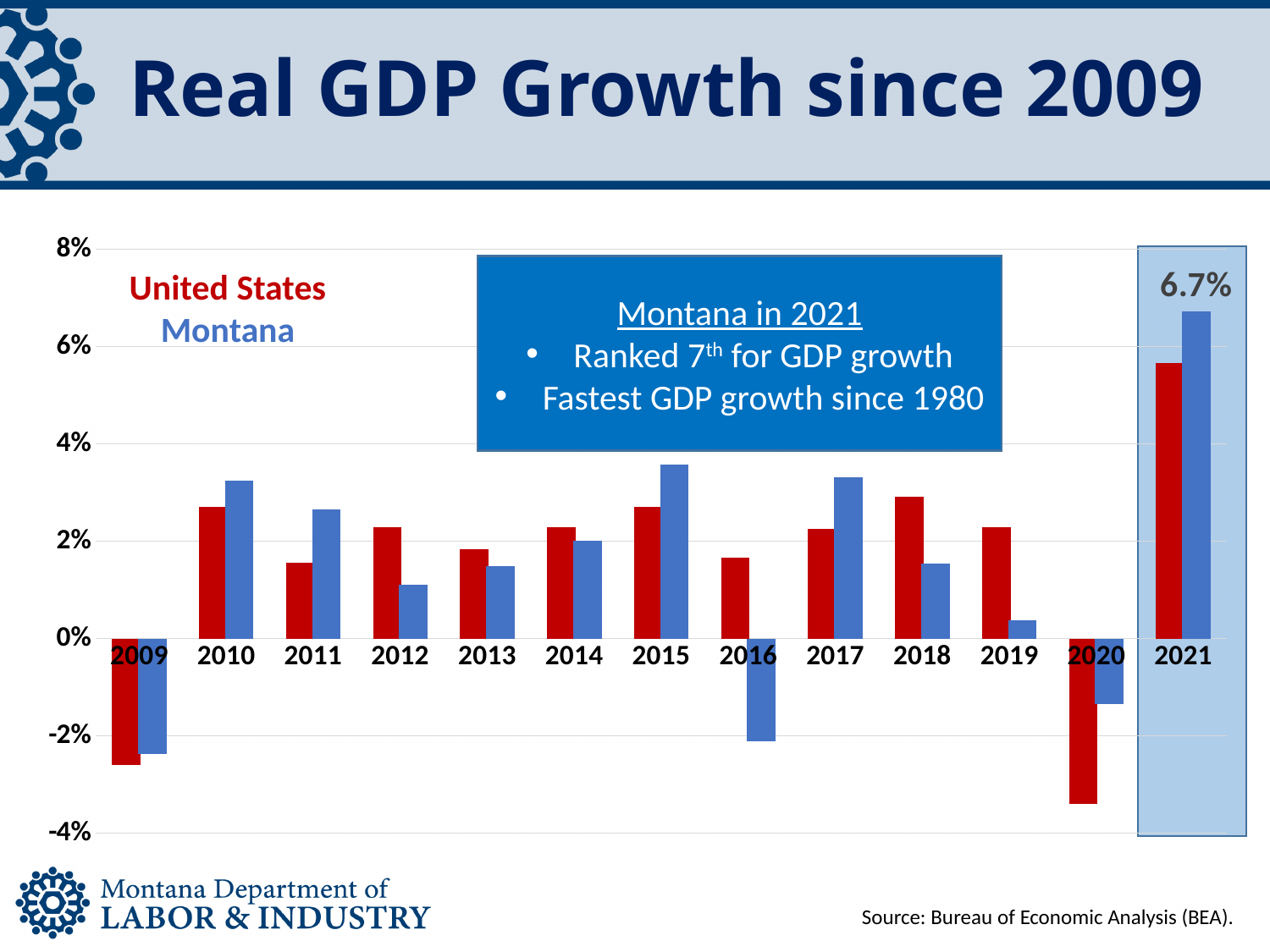
How many years are shown along the x axis of the chart? 13 What is Montana's real GDP growth in 2021 according to the data label? 6.7% In 2010, which had higher real GDP growth, the United States or Montana? Montana What colour are the bars for the Montana series? blue In which year is Montana's real GDP growth the highest? 2021 In 2018, which had higher real GDP growth, the United States or Montana? United States Is the value for Montana in 2016 greater or less than 0%? less In which year is the United States' real GDP growth the lowest? 2020 How many series does the chart's legend list? 2 Is the value for Montana in 2019 greater or less than 2%? less What kind of chart is shown on the slide? bar chart Is the value for the United States in 2020 greater or less than -2%? less